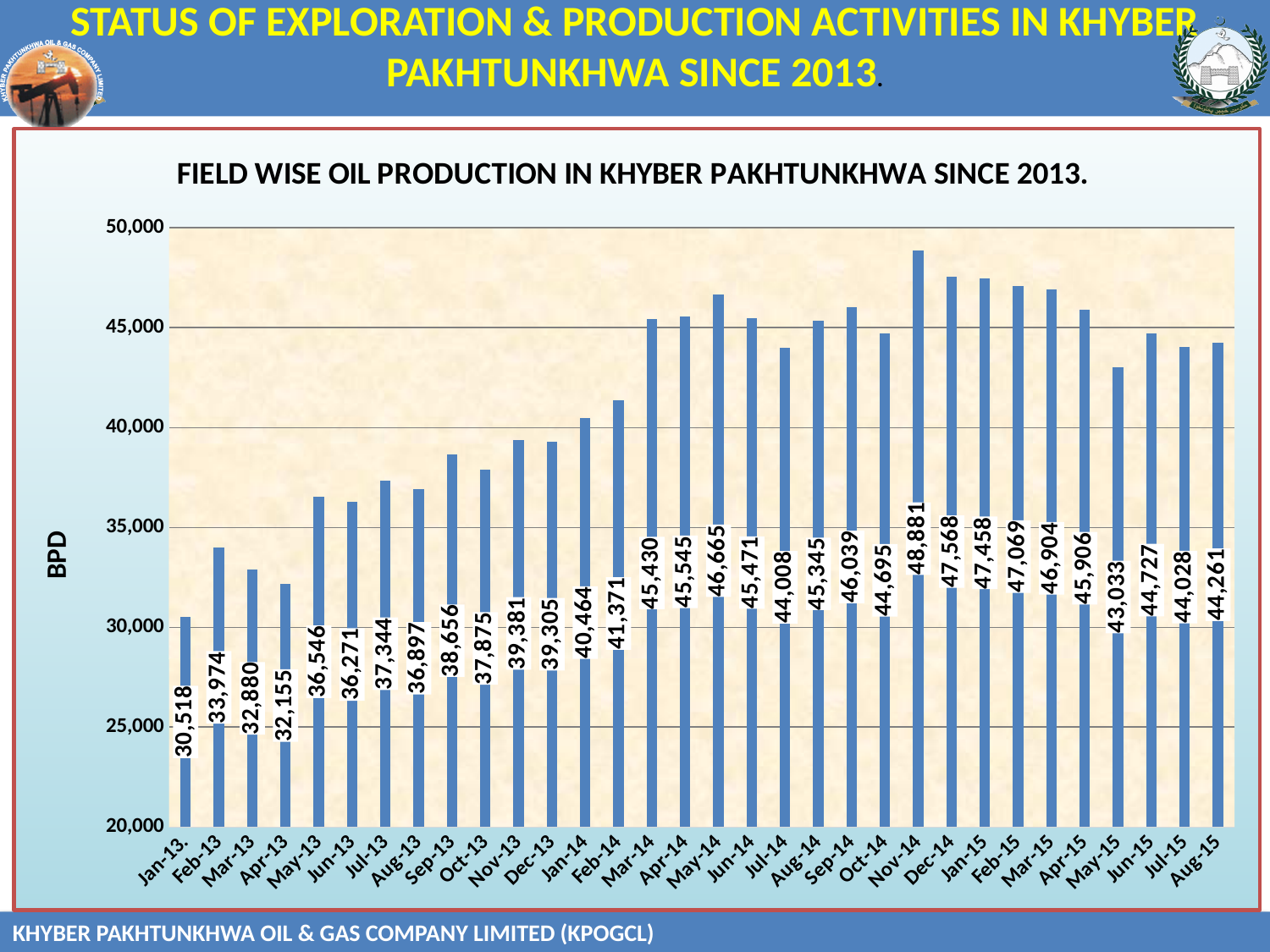
Which month has the highest oil production? Nov-14 What type of chart is shown on the slide? Bar chart Which month has the lowest oil production? Jan-13 Which month has higher oil production, Feb-14 or Mar-14? Mar-14 What is the oil production value for Nov-14? 48,881 What is the oil production value for Aug-15? 44,261 What is the oil production value for Jan-13? 30,518 What is the label on the vertical axis of the chart? BPD Is the value for May-15 greater or less than 45,000? less What is the difference between the oil production in Feb-13 and Jan-13? 3,456 What is the difference between the oil production in Nov-14 and Jan-13? 18,363 How many months are plotted on the chart? 32